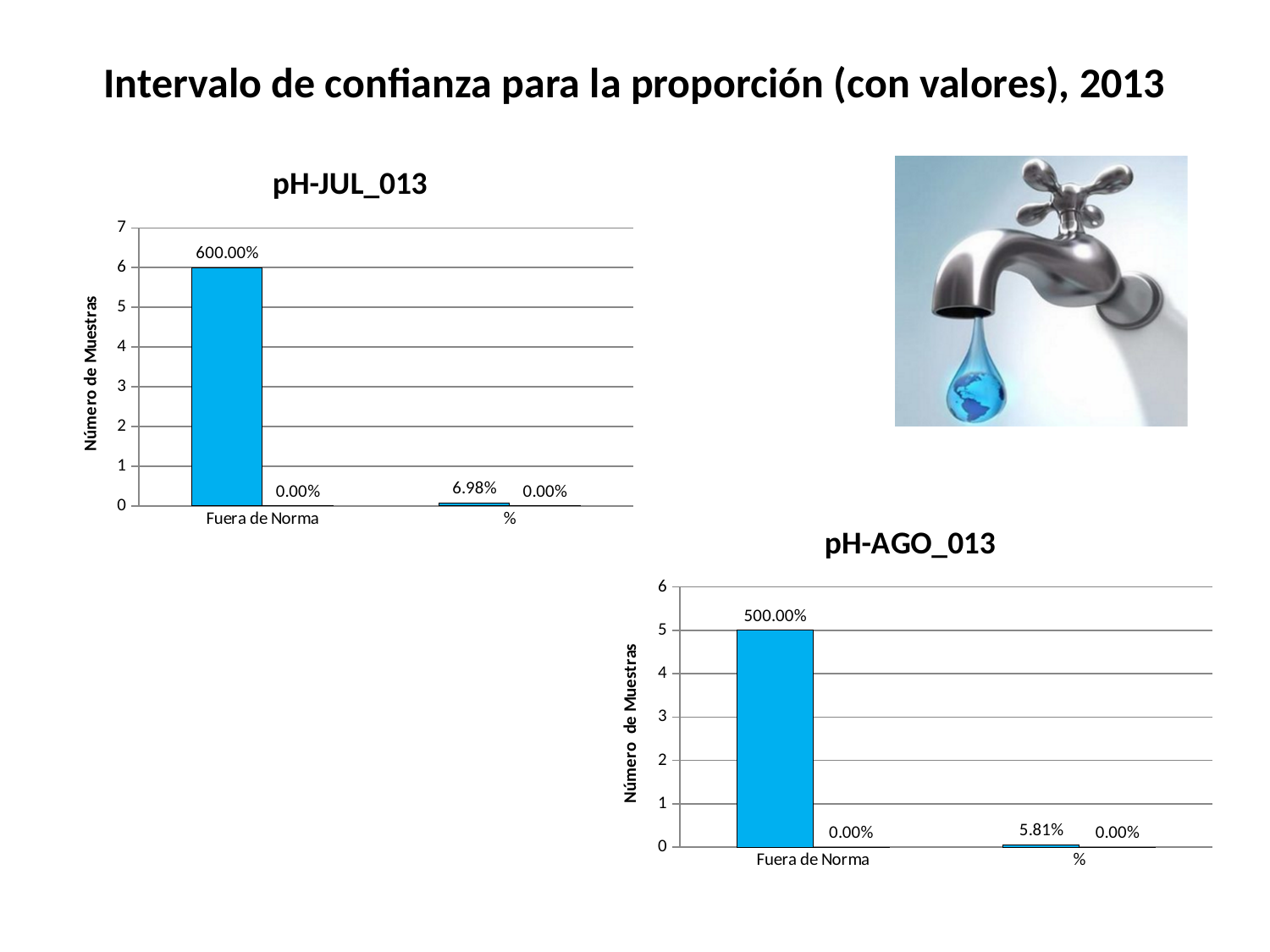
In the pH-AGO_013 chart, what is the data label on the first bar of the % category? 5.81% In the pH-JUL_013 chart, is the tallest bar for Fuera de Norma greater or less than 5 on the y axis? greater How many categories are shown on the x axis of the pH-AGO_013 chart? 2 In the pH-AGO_013 chart, is the tallest bar for Fuera de Norma greater or less than 4 on the y axis? greater In the pH-AGO_013 chart, what is the data label on the tallest bar for Fuera de Norma? 500.00% In the pH-JUL_013 chart, what is the data label on the tallest bar for Fuera de Norma? 600.00% In the pH-JUL_013 chart, which category has the tallest bar? Fuera de Norma In the pH-AGO_013 chart, which category has the tallest bar? Fuera de Norma What kind of chart is pH-JUL_013? Bar chart In the pH-JUL_013 chart, what is the data label on the first bar of the % category? 6.98% What is the y-axis title of the pH-JUL_013 chart? Número de Muestras Which chart has the taller Fuera de Norma bar, pH-JUL_013 or pH-AGO_013? pH-JUL_013